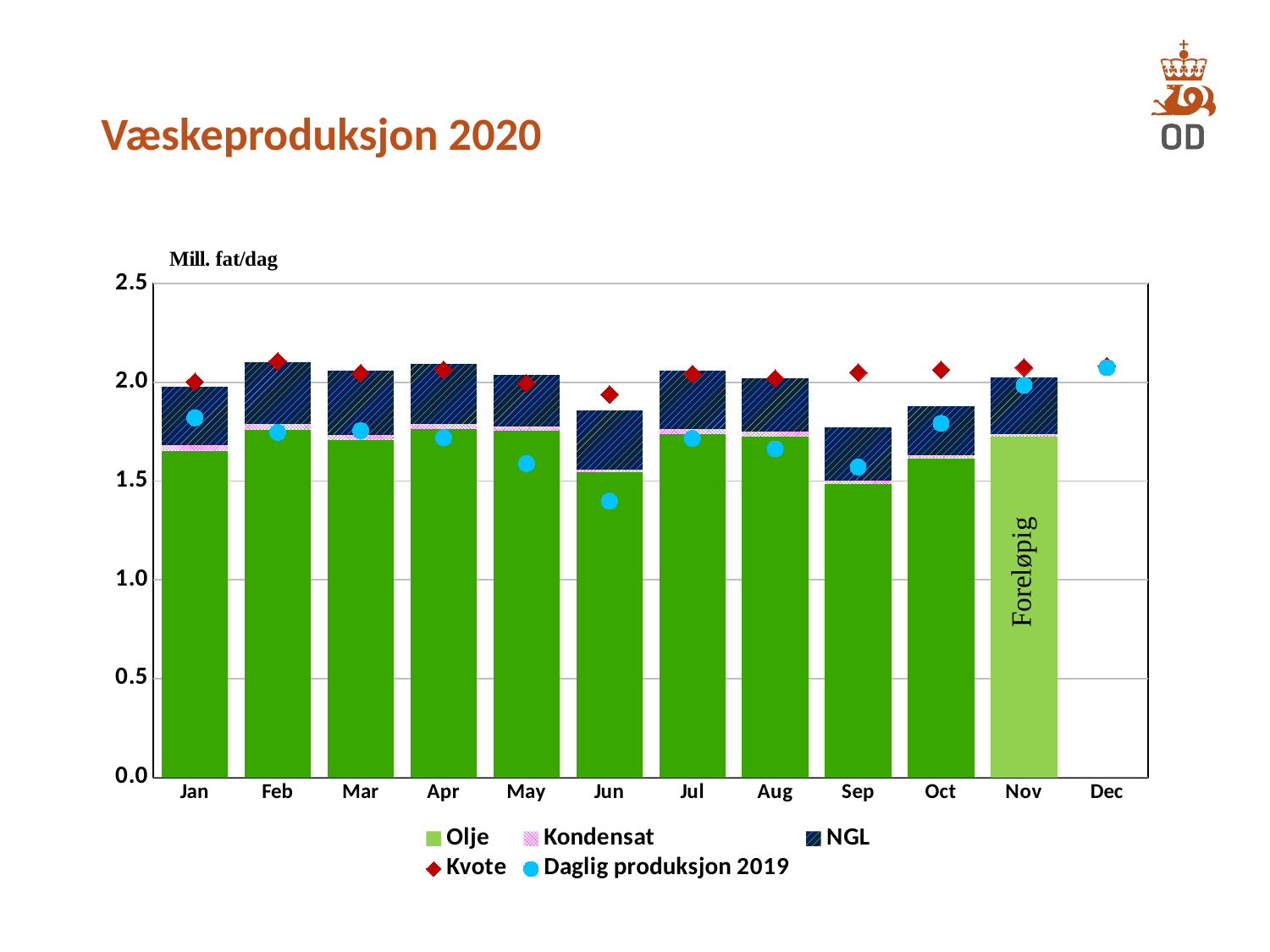
How many months are shown on the x axis? 12 Is the Daglig produksjon 2019 value for Jun greater or less than 1.5? less Is the total stacked bar for Feb greater or less than 2.0? greater What is the title of the chart? Væskeproduksjon 2020 Is the Olje value for Jan greater or less than 1.5? greater What kind of chart is shown on the slide? Combination chart: stacked bar chart with overlaid markers How many series does the legend list? 5 Which has the larger total stacked bar, Jun or Jul? Jul Which month has the lowest Daglig produksjon 2019 value? Jun Which month has the lowest total stacked bar? Sep What unit is shown on the vertical axis? Mill. fat/dag